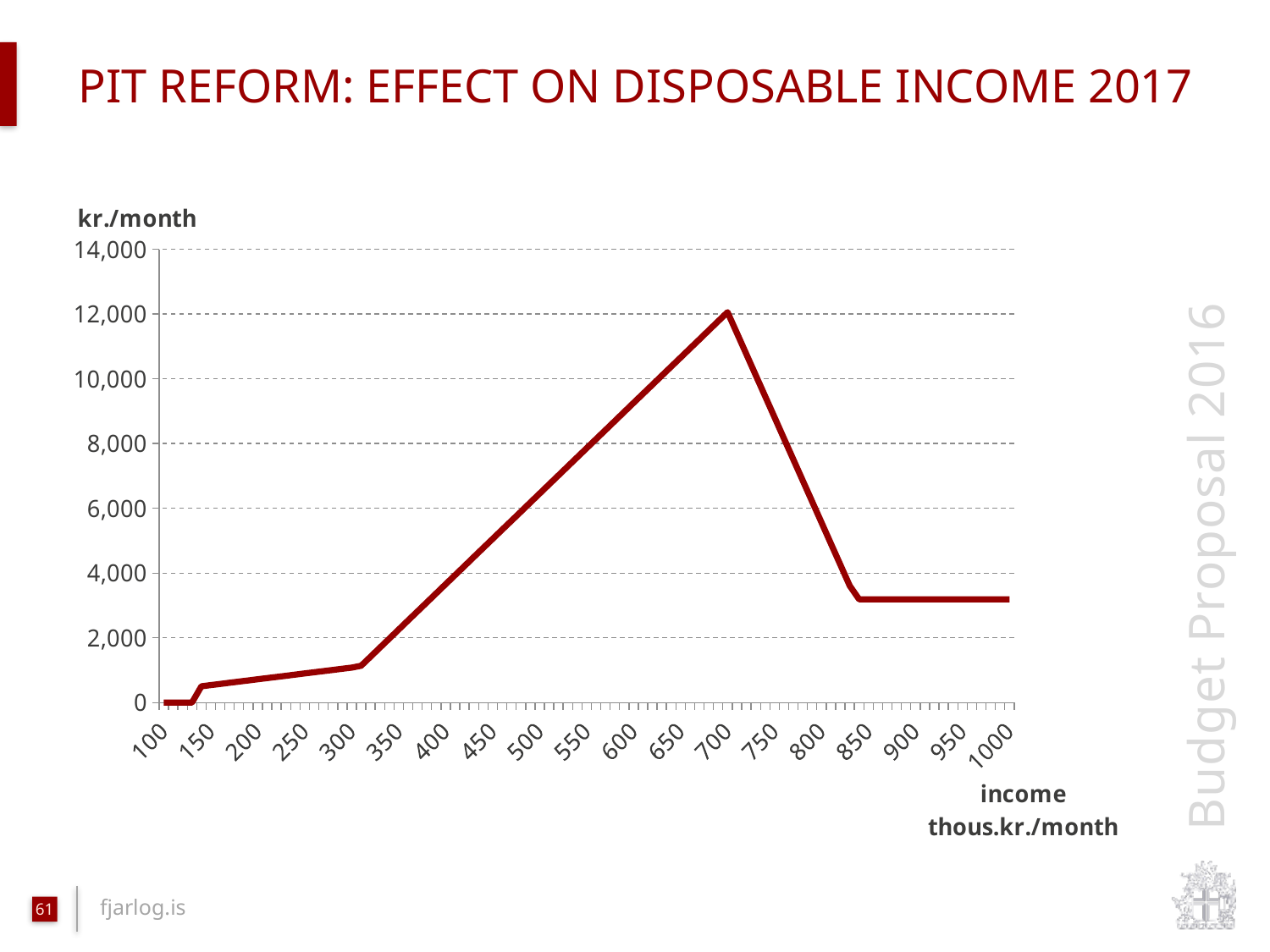
Is the value at income 600 greater or less than 8,000? greater Is the value at income 800 greater or less than 8,000? less Is the value at income 1000 greater or less than 4,000? less What unit label is shown on the vertical axis of the chart? kr./month What kind of chart is shown on the slide? line chart Which is larger, the value at income 300 or the value at income 900? 900 Which is larger, the value at income 700 or the value at income 1000? 700 Does the line rise or fall between income 700 and income 850? fall What is the title of the chart? PIT REFORM: EFFECT ON DISPOSABLE INCOME 2017 At which income level does the line reach its highest value? 700